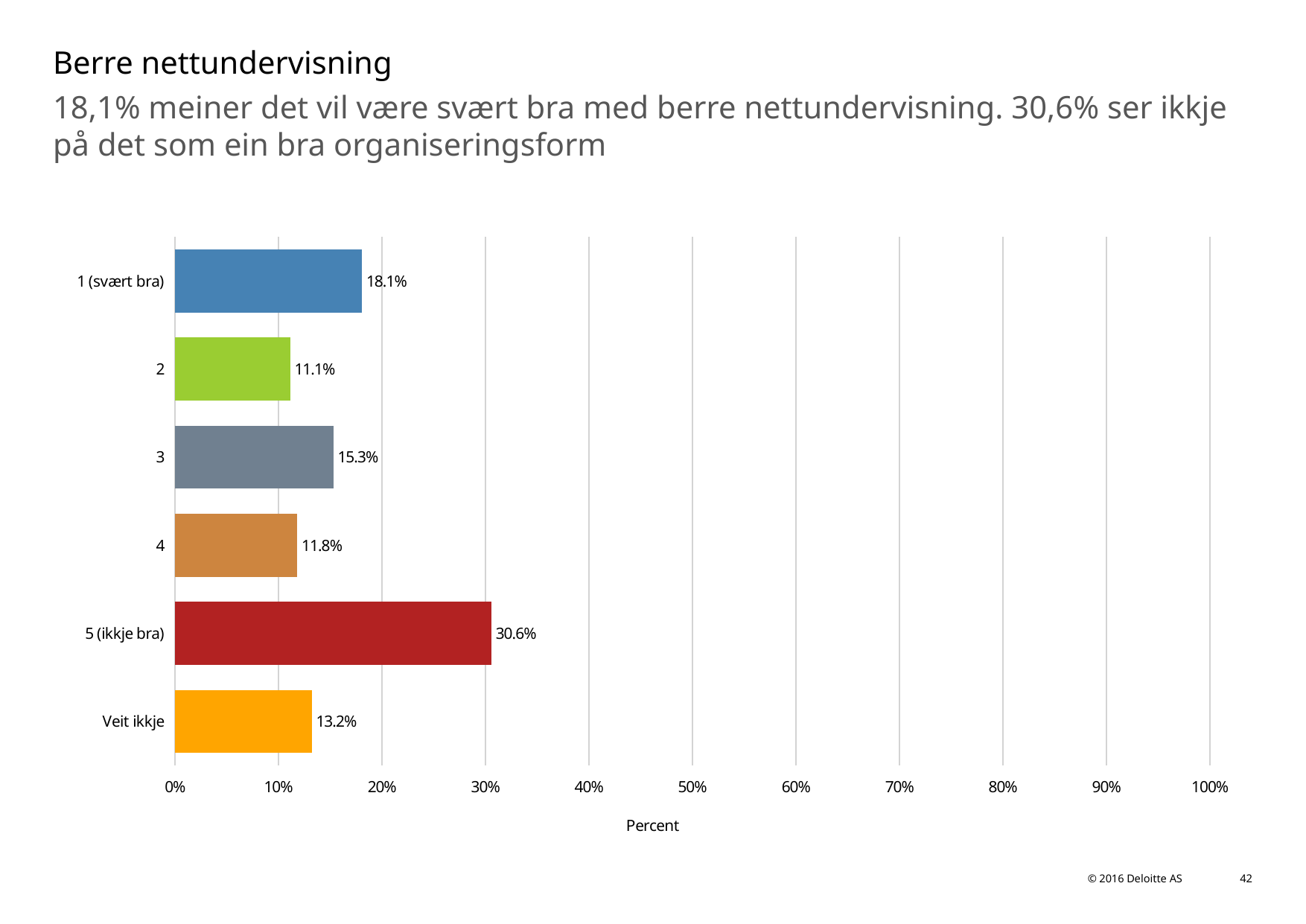
What is the difference between the values for "5 (ikkje bra)" and "1 (svært bra)"? 12.5% What is the value for category "3"? 15.3% What is the value for "1 (svært bra)"? 18.1% What is the value for "5 (ikkje bra)"? 30.6% Is the value for "5 (ikkje bra)" greater or less than 20%? greater What is the label of the horizontal axis? Percent What kind of chart is shown on the slide? Bar chart Which is larger, the value for "3" or the value for "4"? 3 Which category has the lowest value? 2 What is the value for "Veit ikkje"? 13.2% How many categories are shown in the chart? 6 Which category has the highest value? 5 (ikkje bra)